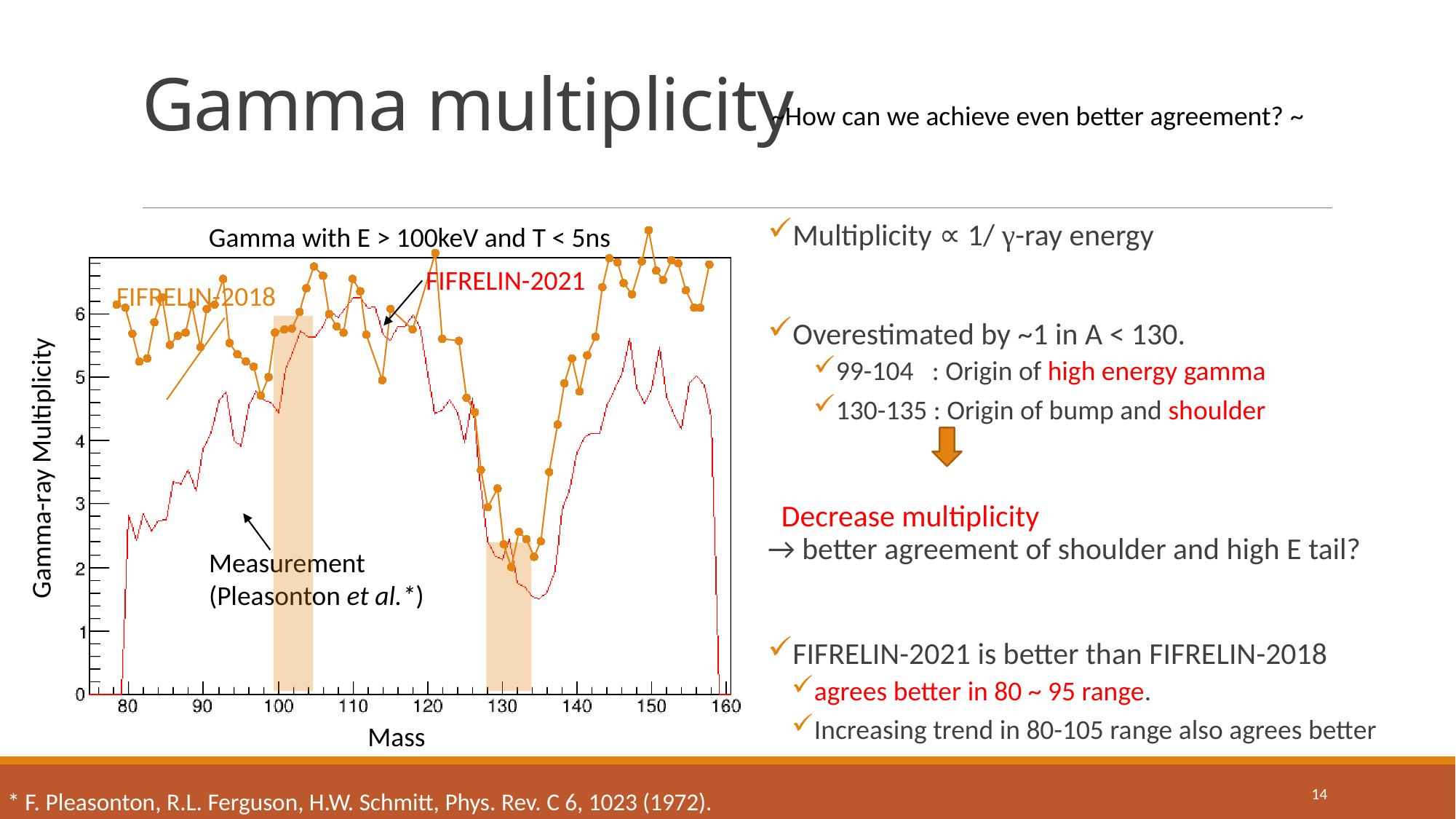
What kind of chart is shown on the slide? line chart Does the FIFRELIN-2021 series rise or fall between mass 135 and mass 145? rise At mass 100, which is larger: the FIFRELIN-2021 value or the Measurement value? FIFRELIN-2021 What is the label of the y axis of the chart? Gamma-ray Multiplicity Is the Measurement value at mass 135 greater or less than 2? less How many data series are plotted in the chart? 3 Is the FIFRELIN-2021 value at mass 150 greater or less than 6? greater Is the Measurement value at mass 80 greater or less than 4? less What is the title of the chart? Gamma with E > 100keV and T < 5ns Does the FIFRELIN-2021 series rise or fall between mass 120 and mass 135? fall